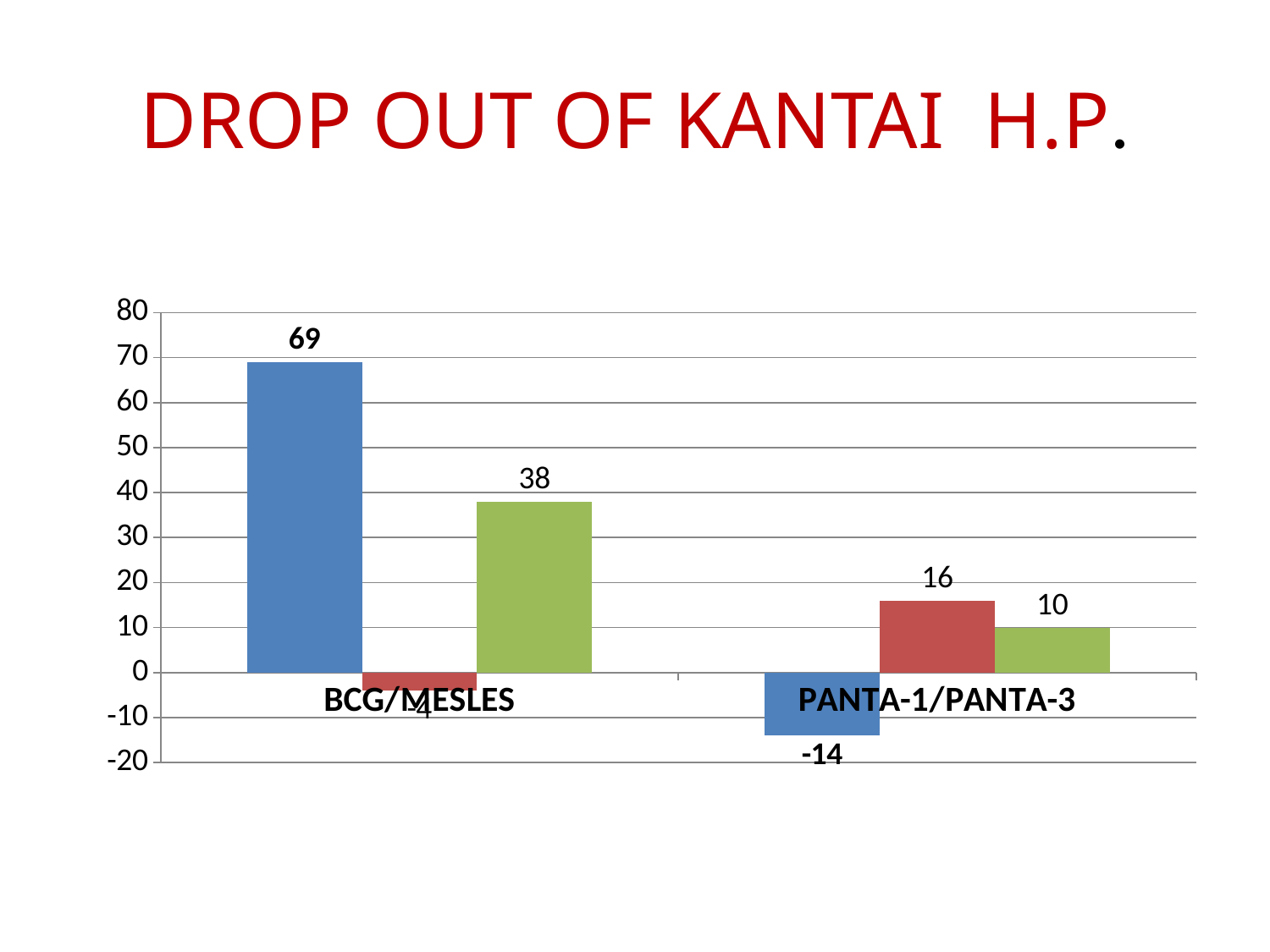
What type of chart is shown on the slide? Bar chart What is the value of the blue bar for BCG/MESLES? 69 Which is larger, the green bar for BCG/MESLES or the red bar for PANTA-1/PANTA-3? The green bar for BCG/MESLES How many categories are shown on the x axis? 2 Which bar has the lowest value on the chart? The blue bar for PANTA-1/PANTA-3 (-14) What is the difference between the red bar and the green bar for PANTA-1/PANTA-3? 6 Which bar has the highest value on the chart? The blue bar for BCG/MESLES (69) What is the value of the red bar for PANTA-1/PANTA-3? 16 What is the difference between the blue bar and the green bar for BCG/MESLES? 31 What is the value of the blue bar for PANTA-1/PANTA-3? -14 What is the value of the green bar for BCG/MESLES? 38 What is the value of the green bar for PANTA-1/PANTA-3? 10